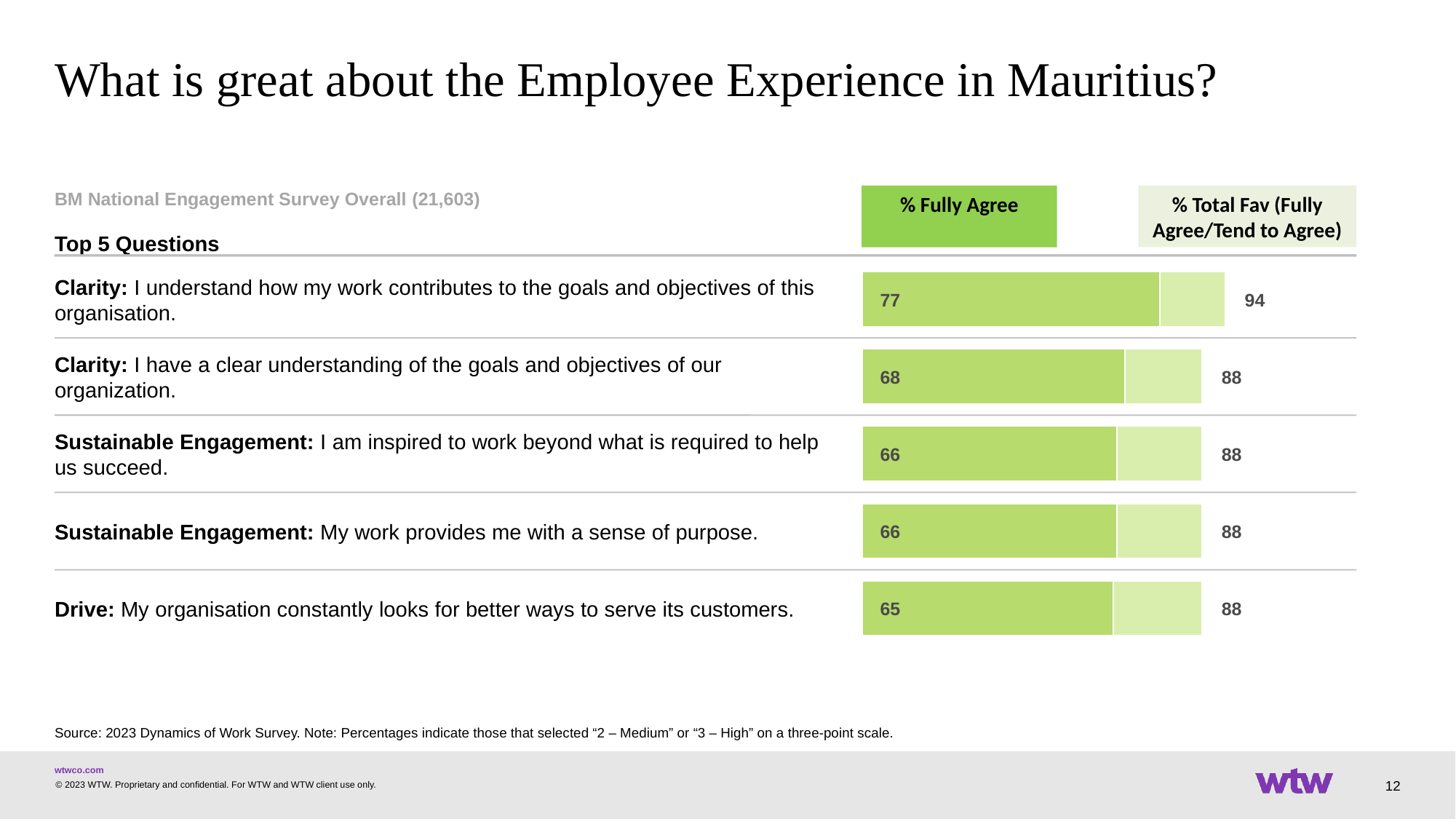
What is the % Total Fav value for "Sustainable Engagement: My work provides me with a sense of purpose"? 88 Which has a higher % Fully Agree value: "Clarity: I have a clear understanding of the goals and objectives of our organization" or "Drive: My organisation constantly looks for better ways to serve its customers"? Clarity: I have a clear understanding of the goals and objectives of our organization. How many questions are shown in the chart? 5 What is the difference in % Fully Agree between the two Clarity questions? 9 What is the % Fully Agree value for "Clarity: I have a clear understanding of the goals and objectives of our organization"? 68 How many series does the chart legend list? 2 Which question has the highest % Fully Agree value? Clarity: I understand how my work contributes to the goals and objectives of this organisation. What is the % Fully Agree value for "Clarity: I understand how my work contributes to the goals and objectives of this organisation"? 77 What is the difference between the % Total Fav and % Fully Agree values for "Clarity: I understand how my work contributes to the goals and objectives of this organisation"? 17 What kind of chart is shown on the slide? Bar chart Which question has the lowest % Fully Agree value? Drive: My organisation constantly looks for better ways to serve its customers. What is the % Total Fav value for "Drive: My organisation constantly looks for better ways to serve its customers"? 88